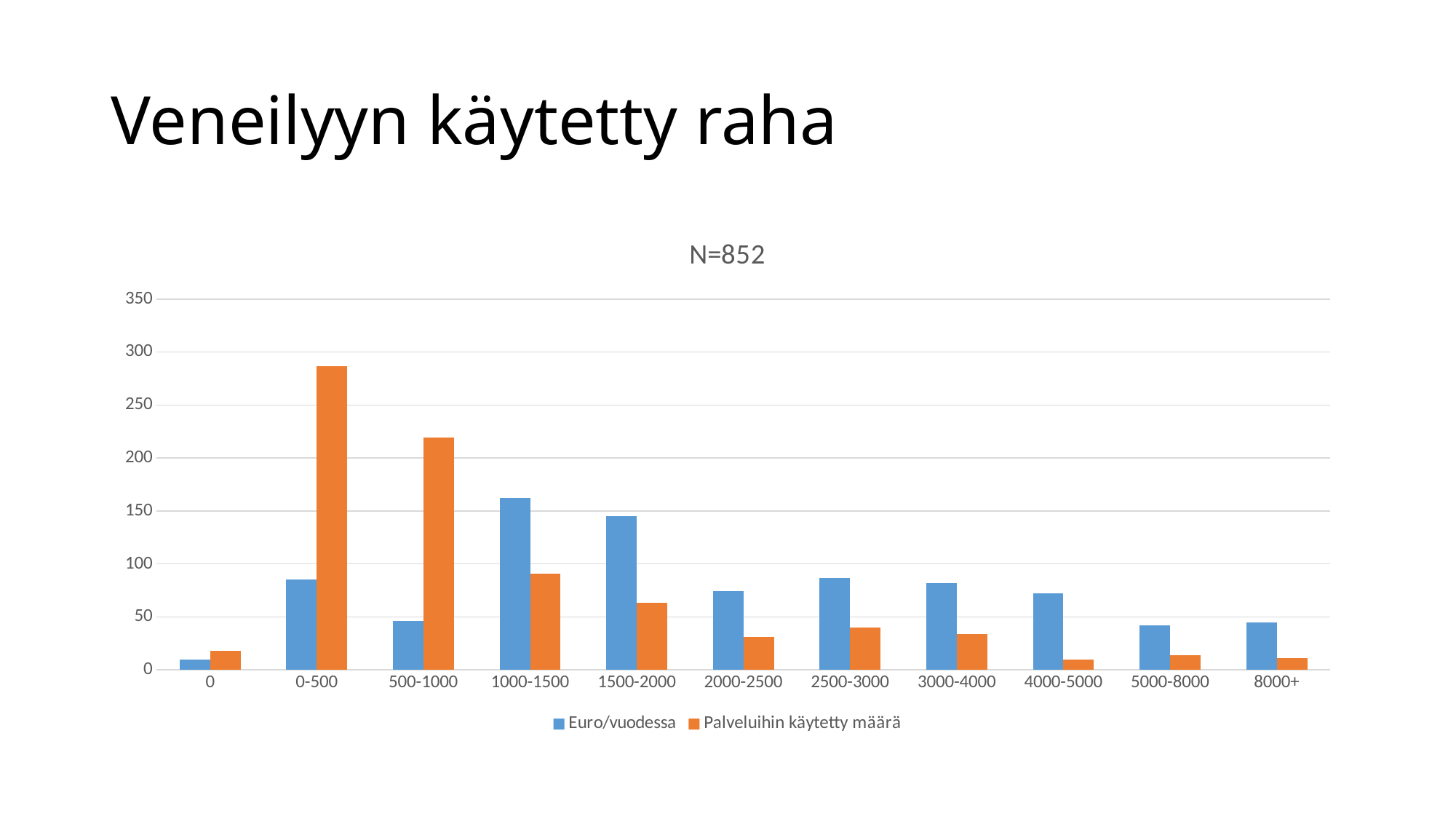
Is the value for Euro/vuodessa in the 1000-1500 category greater or less than 150? greater Which category has the highest value for Euro/vuodessa? 1000-1500 Is the value for Euro/vuodessa in the 2000-2500 category greater or less than 100? less Is the value for Palveluihin käytetty määrä in the 0-500 category greater or less than 250? greater How many categories are shown on the x axis? 11 How many series does the legend list? 2 In the 1000-1500 category, which series has the larger value, Euro/vuodessa or Palveluihin käytetty määrä? Euro/vuodessa What type of chart is shown on the slide? bar chart Which category has the lowest value for Euro/vuodessa? 0 In the 0-500 category, which series has the larger value, Euro/vuodessa or Palveluihin käytetty määrä? Palveluihin käytetty määrä Which category has the highest value for Palveluihin käytetty määrä? 0-500 What is the title shown above the chart? N=852